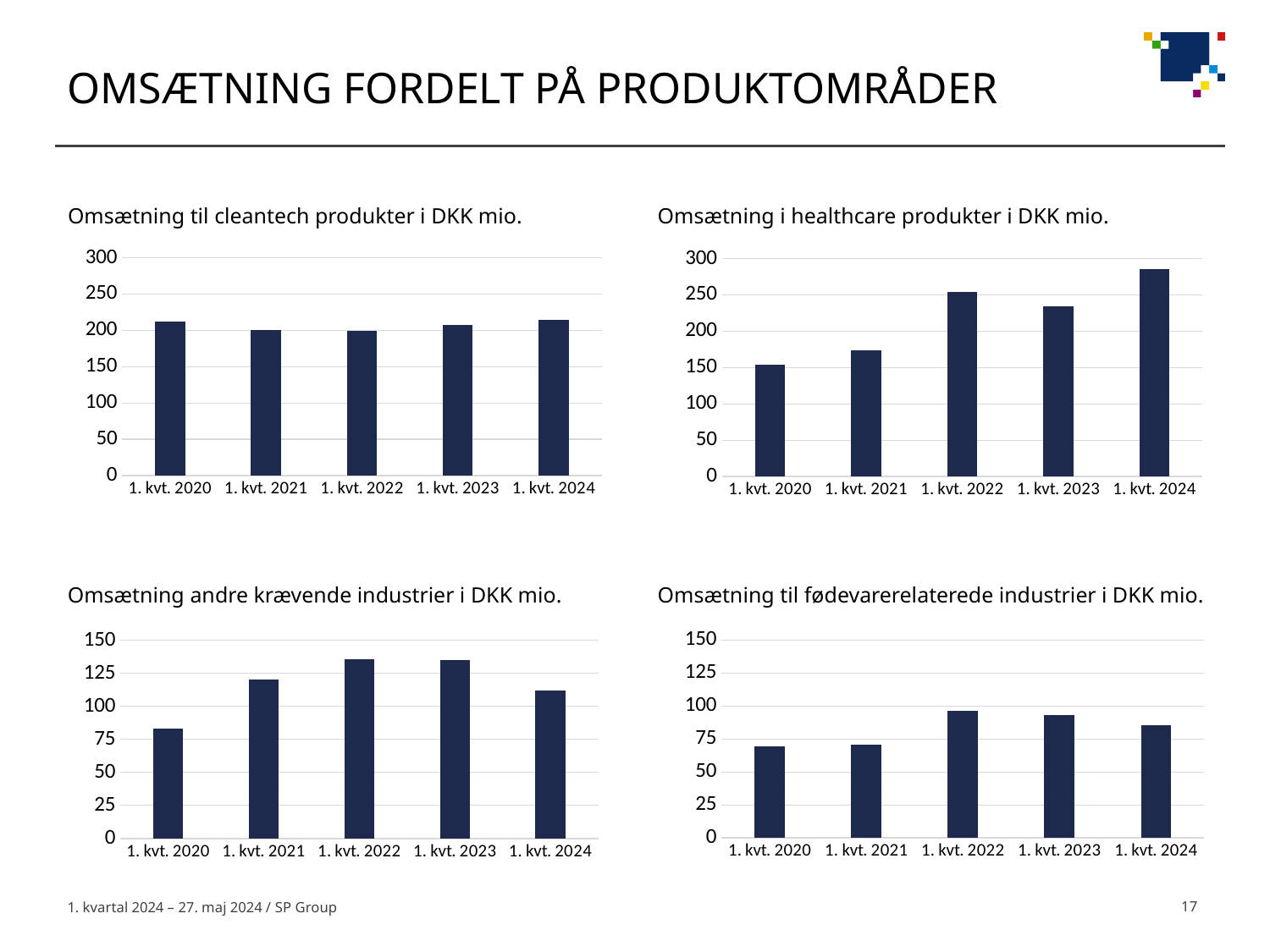
On the chart 'Omsætning i healthcare produkter i DKK mio.', which quarter has the highest value? 1. kvt. 2024 On the chart 'Omsætning andre krævende industrier i DKK mio.', is the value for 1. kvt. 2024 greater or less than 100? greater On the chart 'Omsætning andre krævende industrier i DKK mio.', which is larger: the value for 1. kvt. 2021 or 1. kvt. 2024? 1. kvt. 2021 How many quarters are shown on the chart 'Omsætning til cleantech produkter i DKK mio.'? 5 On the chart 'Omsætning til cleantech produkter i DKK mio.', is the value for 1. kvt. 2020 greater or less than 200? greater How many charts are shown on the slide? 4 On the chart 'Omsætning i healthcare produkter i DKK mio.', is the value for 1. kvt. 2024 greater or less than 250? greater On the chart 'Omsætning andre krævende industrier i DKK mio.', which quarter has the lowest value? 1. kvt. 2020 On the chart 'Omsætning i healthcare produkter i DKK mio.', which quarter has the lowest value? 1. kvt. 2020 What kind of chart is 'Omsætning til fødevarerelaterede industrier i DKK mio.'? bar chart On the chart 'Omsætning i healthcare produkter i DKK mio.', which is larger: the value for 1. kvt. 2022 or 1. kvt. 2023? 1. kvt. 2022